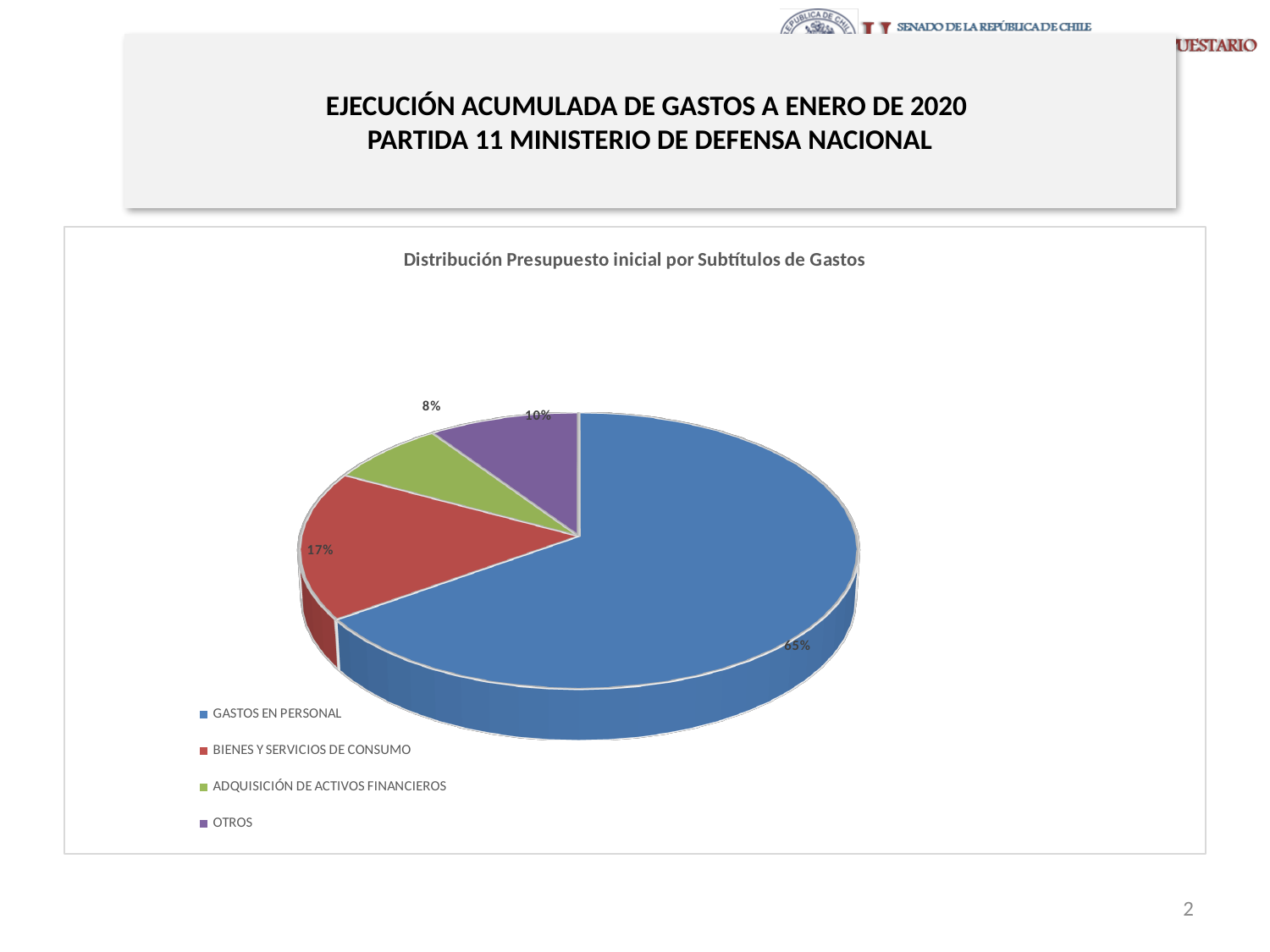
What share of the pie does ADQUISICIÓN DE ACTIVOS FINANCIEROS represent? 8% What share of the pie does GASTOS EN PERSONAL represent? 65% What is the title of the chart? Distribución Presupuesto inicial por Subtítulos de Gastos What share of the pie does OTROS represent? 10% What kind of chart is shown on the slide? pie chart Which colour represents BIENES Y SERVICIOS DE CONSUMO in the pie chart? red Which is larger, the share for OTROS or the share for ADQUISICIÓN DE ACTIVOS FINANCIEROS? OTROS Which category has the largest slice of the pie? GASTOS EN PERSONAL Which category has the smallest slice of the pie? ADQUISICIÓN DE ACTIVOS FINANCIEROS What is the difference in percentage points between GASTOS EN PERSONAL and BIENES Y SERVICIOS DE CONSUMO? 48 percentage points How many slices does the pie chart have? 4